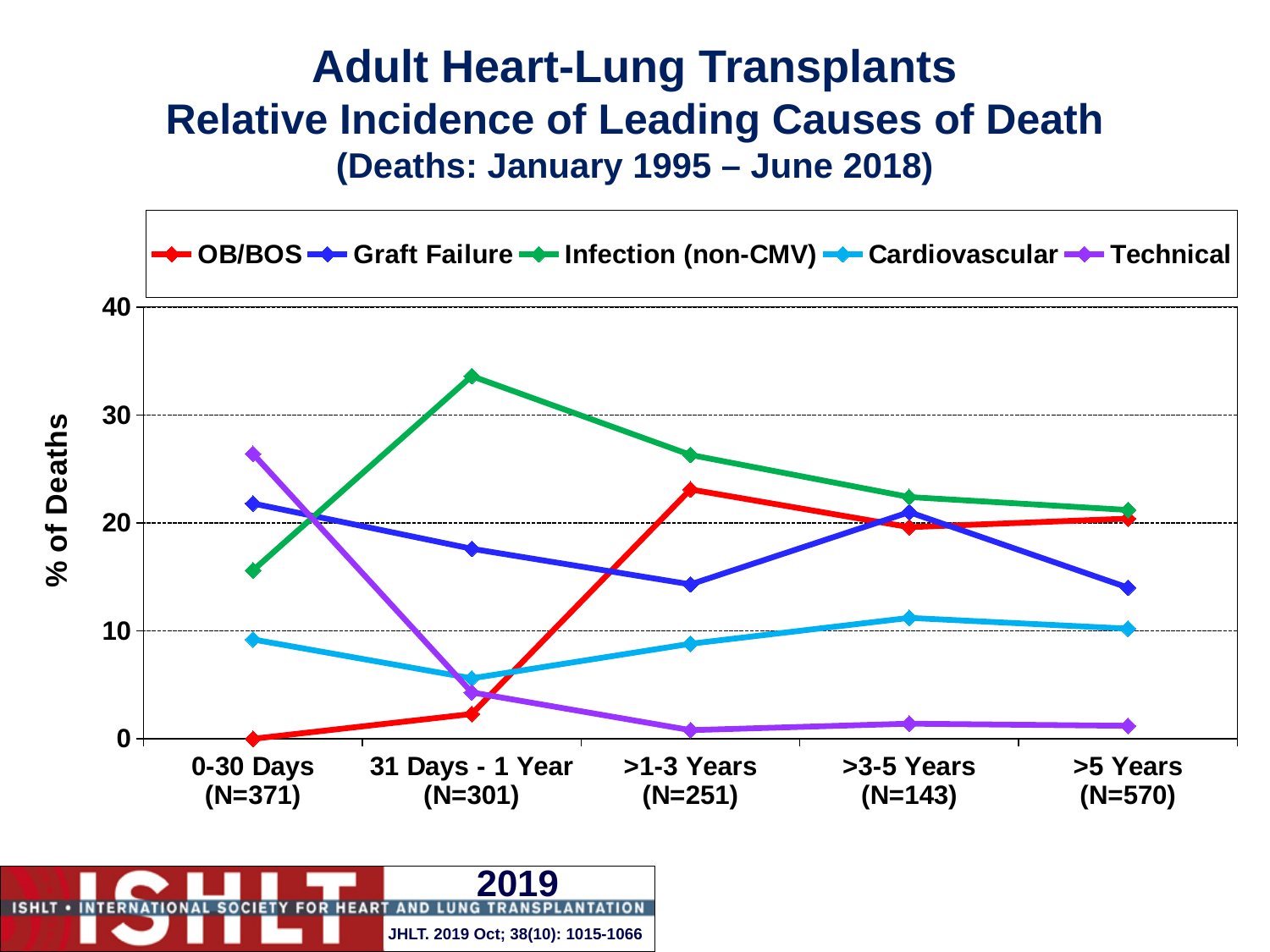
How many series does the legend list? 5 What is the N shown for the >5 Years category? N=570 How many time periods are shown along the x axis? 5 Is the value for Graft Failure at 0-30 Days greater or less than 20? greater Is the value for Technical at >1-3 Years greater or less than 10? less Does the Technical line rise or fall from 0-30 Days to 31 Days - 1 Year? fall What kind of chart is shown on the slide? line chart Which cause of death has the highest % of deaths at 31 Days - 1 Year? Infection (non-CMV) Is the value for Infection (non-CMV) at 31 Days - 1 Year greater or less than 30? greater Which cause of death has the highest % of deaths at 0-30 Days? Technical Which cause of death has the lowest % of deaths at 0-30 Days? OB/BOS At >5 Years, which is larger: Graft Failure or Cardiovascular? Graft Failure